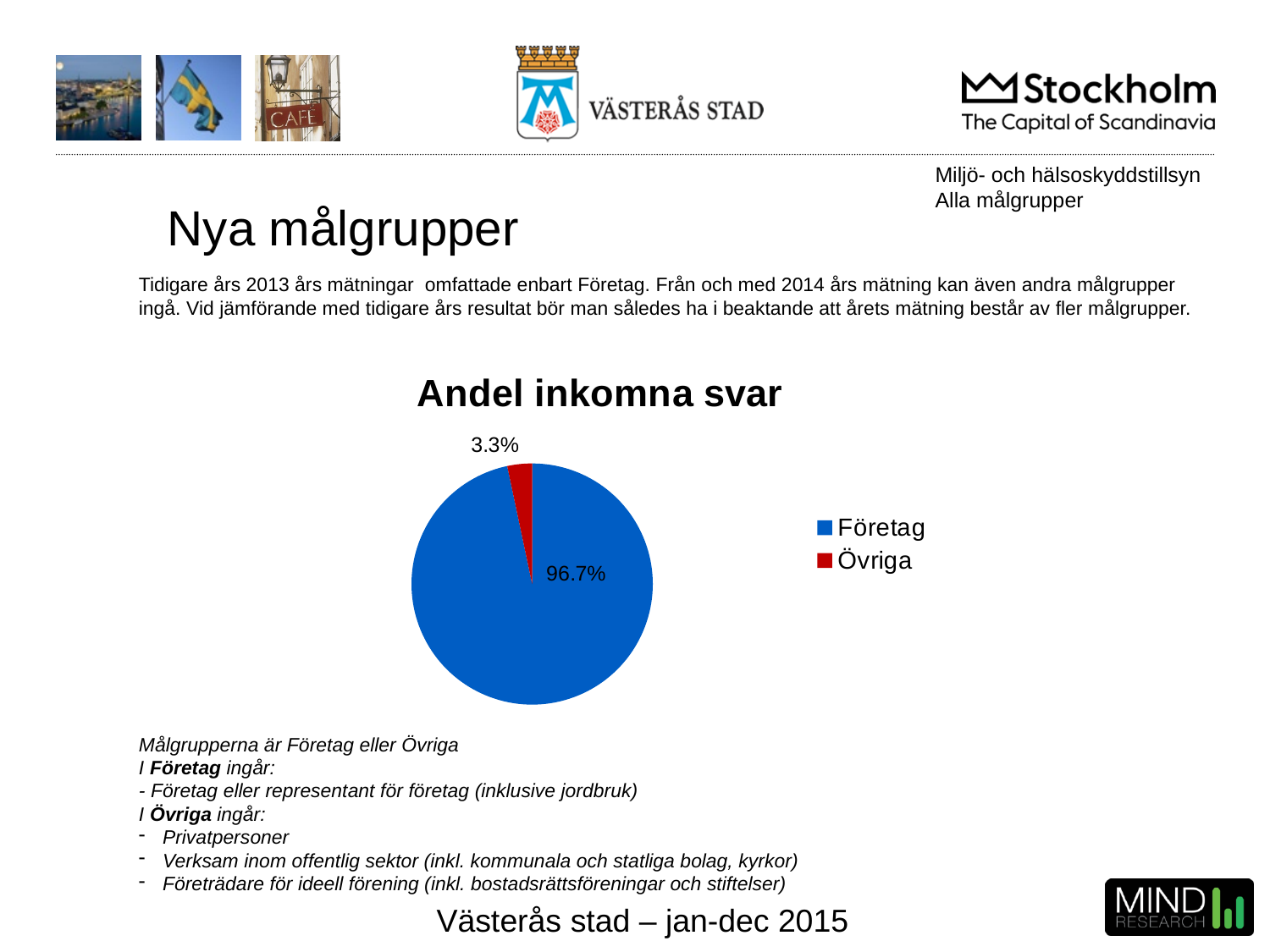
What is the title of the pie chart? Andel inkomna svar Which is larger, the share for Företag or the share for Övriga? Företag What colour is the Övriga slice in the pie chart? red Which category has the largest share of the pie chart? Företag What is the value for Övriga in the pie chart? 3.3% What kind of chart is shown under the title "Andel inkomna svar"? pie chart Which category has the smallest share of the pie chart? Övriga How many slices does the pie chart have? 2 What is the value for Företag in the pie chart? 96.7% What is the difference between the Företag share and the Övriga share? 93.4% What share of the pie does the Övriga slice represent? 3.3% How many entries does the legend of the pie chart list? 2